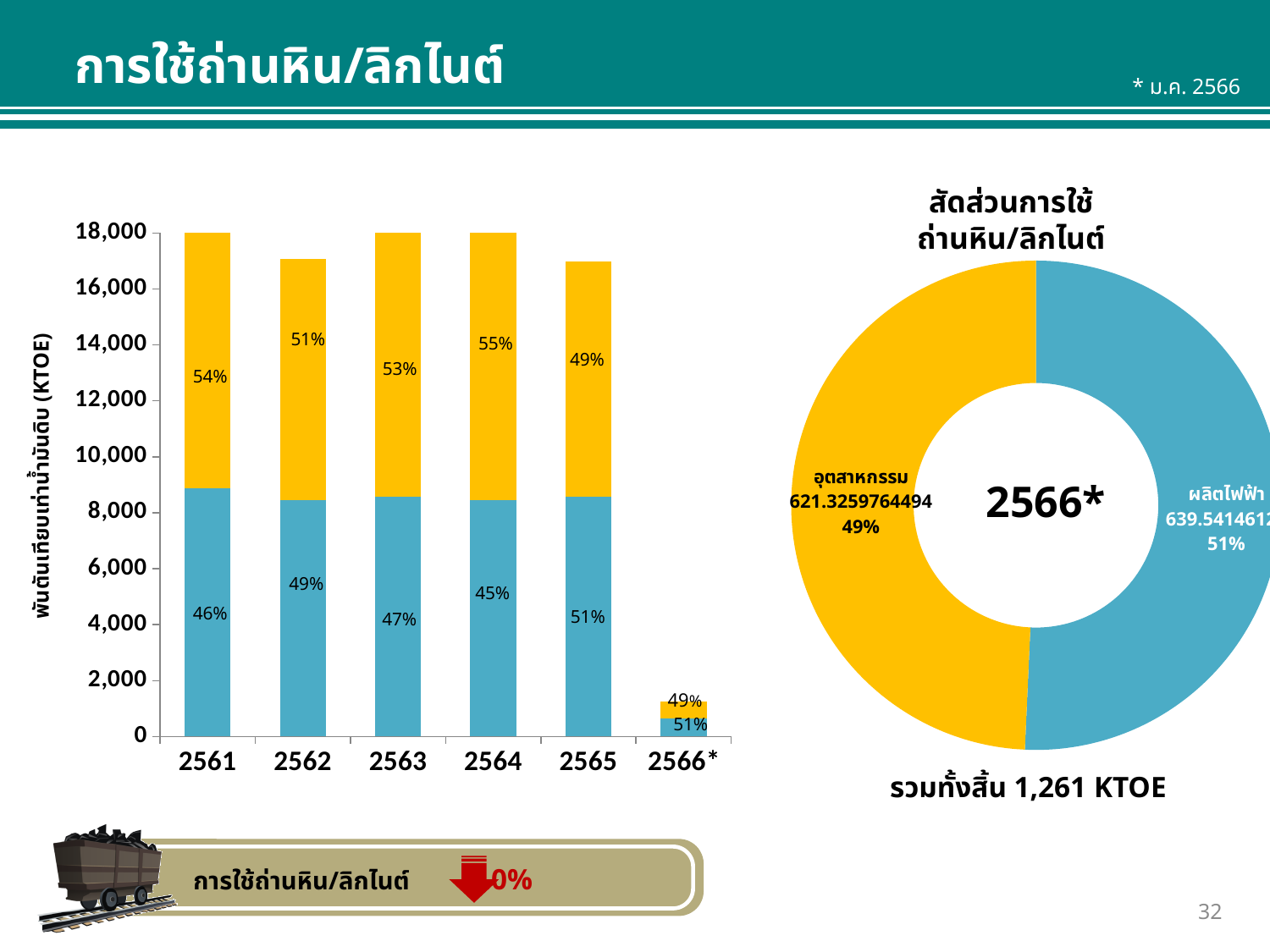
In the left bar chart, which year has the lowest total bar? 2566* In the left bar chart, what percentage label is shown on the blue (lower) segment for 2561? 46% In the donut chart titled สัดส่วนการใช้ถ่านหิน/ลิกไนต์, what share does อุตสาหกรรม have? 49% In the left bar chart, what percentage label is shown on the yellow (upper) segment for 2564? 55% What kind of chart is the chart on the left side of the slide? Stacked bar chart In the left bar chart, what percentage label is shown on the blue (lower) segment for 2565? 51% In the donut chart titled สัดส่วนการใช้ถ่านหิน/ลิกไนต์, which slice is larger, อุตสาหกรรม or ผลิตไฟฟ้า? ผลิตไฟฟ้า In the donut chart titled สัดส่วนการใช้ถ่านหิน/ลิกไนต์, what value is printed for อุตสาหกรรม? 621.3259764494 In the left bar chart, is the total height of the bar for 2566* greater or less than 2,000? less How many years (categories) are shown on the x axis of the left bar chart? 6 What total is printed below the donut chart titled สัดส่วนการใช้ถ่านหิน/ลิกไนต์? 1,261 KTOE In the left bar chart, is the total height of the bar for 2561 greater or less than 16,000? greater